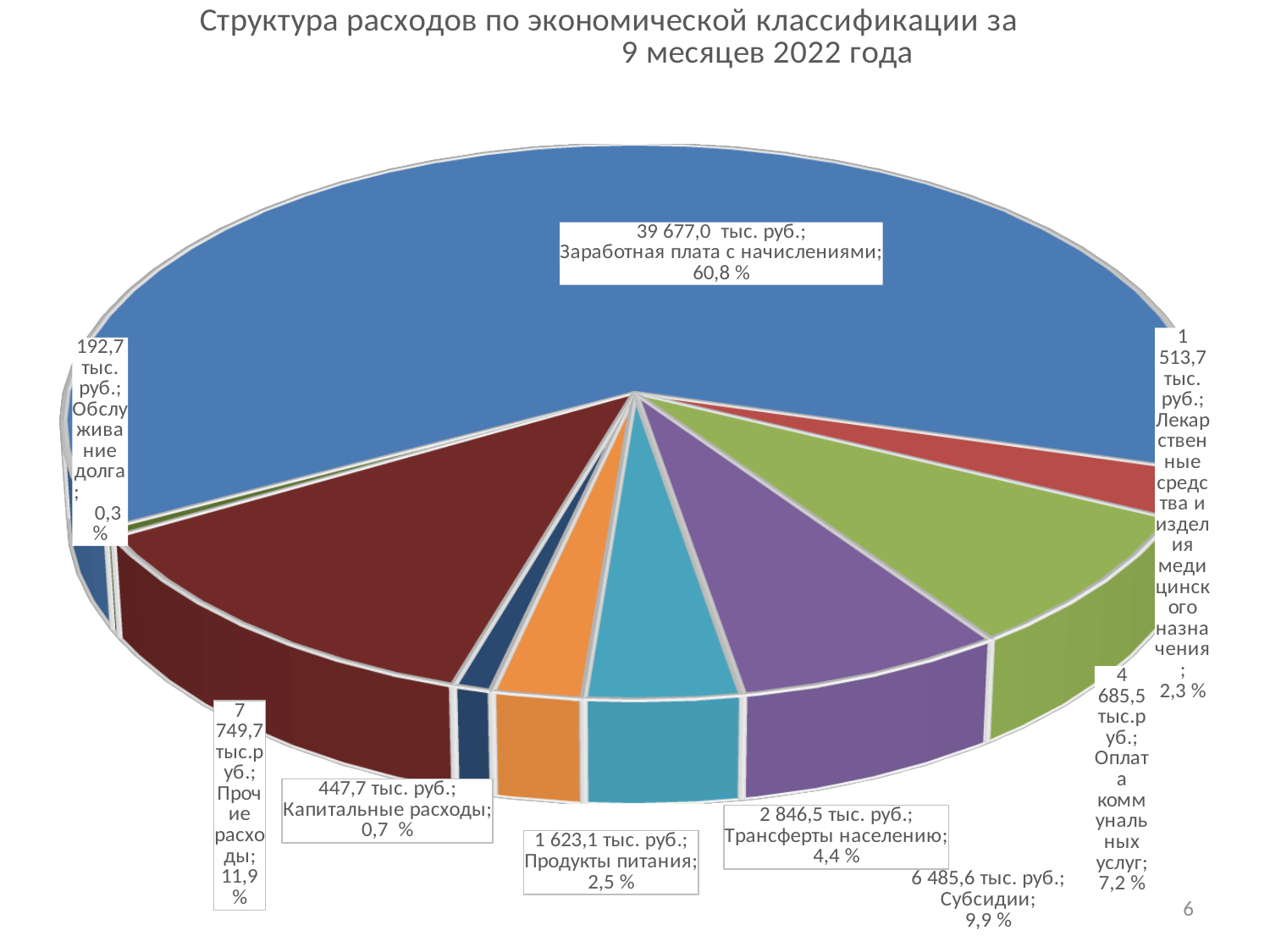
What is the value for Субсидии? 6 485,6 тыс. руб. What share of the pie does Прочие расходы take? 11,9 % What is the title of the chart? Структура расходов по экономической классификации за 9 месяцев 2022 года Which category has the largest share of the pie? Заработная плата с начислениями What kind of chart is shown on the slide? Pie chart What share of the pie does Заработная плата с начислениями take? 60,8 % Which category has the smallest share of the pie? Обслуживание долга Which is larger, Субсидии or Трансферты населению? Субсидии What is the difference in percentage share between Прочие расходы and Оплата коммунальных услуг? 4,7 % What is the value for Заработная плата с начислениями? 39 677,0 тыс. руб. What is the value for Оплата коммунальных услуг? 4 685,5 тыс.руб. What share of the pie does Капитальные расходы take? 0,7 %